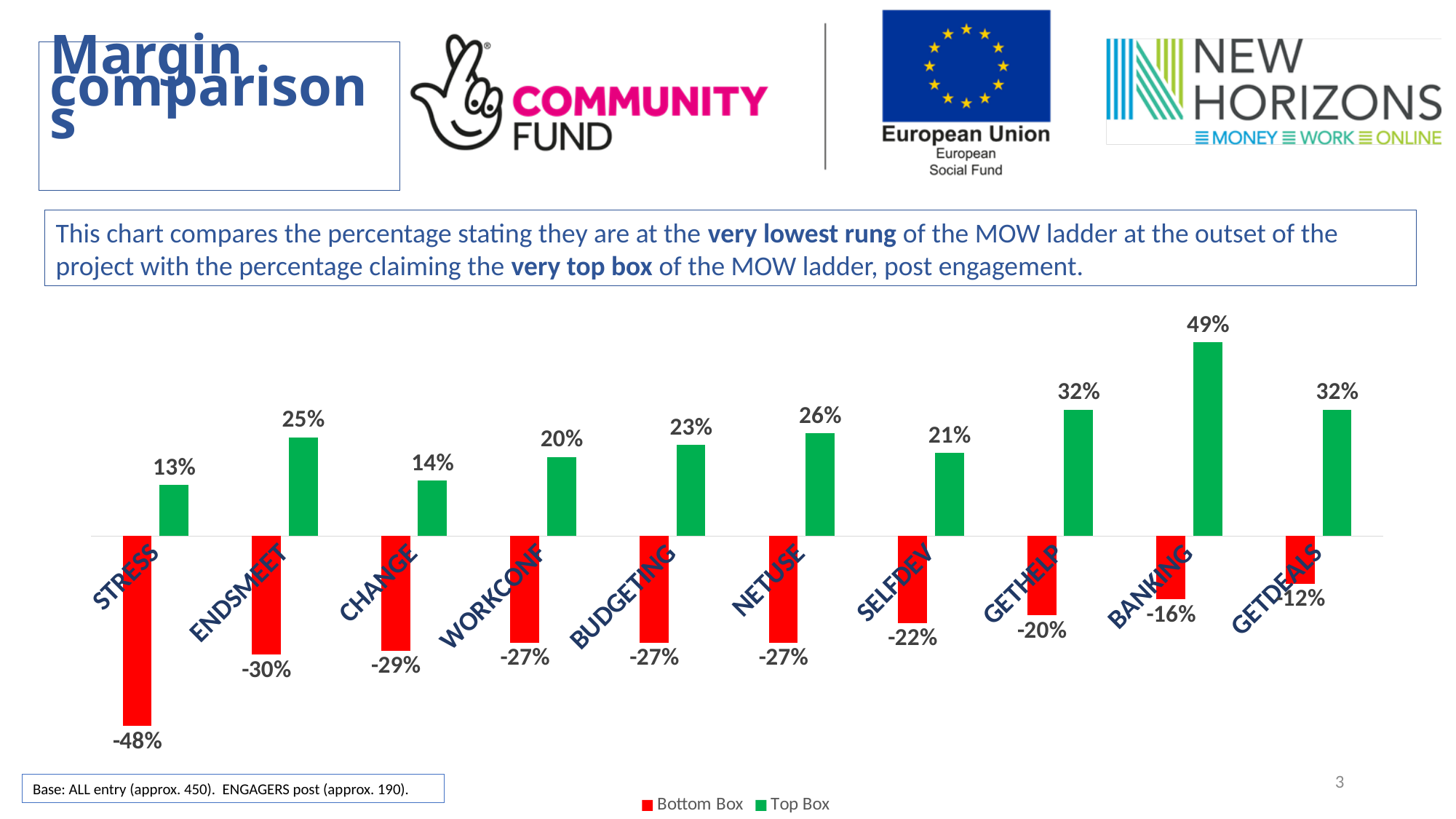
What colour are the Bottom Box bars? Red What is the Bottom Box value for GETDEALS? -12% How many series does the legend list? 2 Which has a larger Top Box value, ENDSMEET or SELFDEV? ENDSMEET What kind of chart is shown on the slide? Bar chart What is the difference between the Top Box values for BANKING and GETHELP? 17% How many categories are shown on the x axis? 10 What is the Bottom Box value for STRESS? -48% What is the Top Box value for NETUSE? 26% Which category has the highest Top Box value? BANKING Which category has the lowest Top Box value? STRESS What is the Top Box value for BANKING? 49%